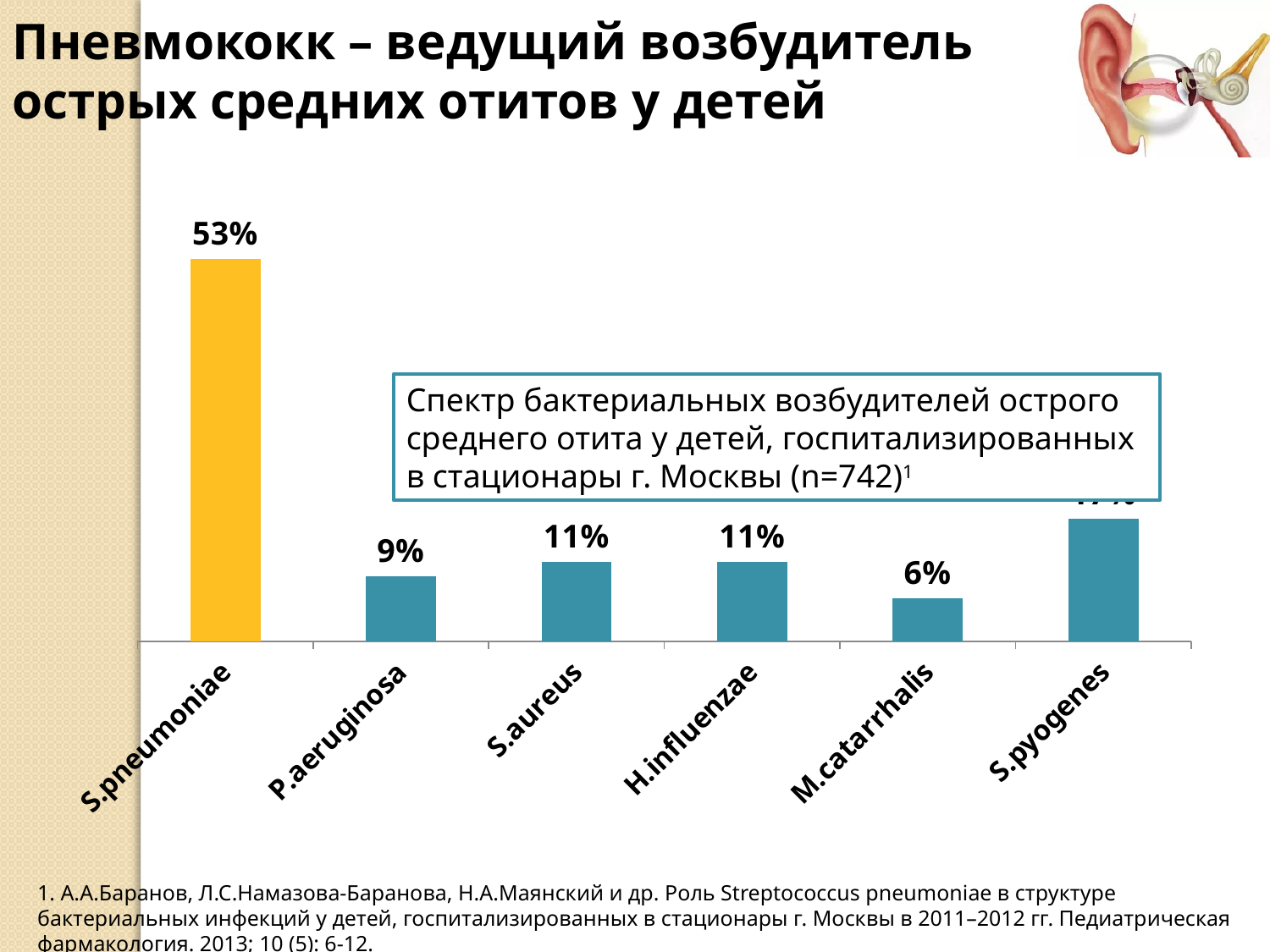
What kind of chart is shown on the slide? Bar chart What is the value for P.aeruginosa? 9% What is the value for M.catarrhalis? 6% What is the value for S.pneumoniae? 53% Which is larger, the value for S.pyogenes or the value for S.aureus? S.pyogenes Which category's bar is coloured differently (yellow) from the others? S.pneumoniae What is the value for S.aureus? 11% How many categories are shown on the chart? 6 Which category has the highest value? S.pneumoniae What is the difference between the values for S.pneumoniae and P.aeruginosa? 44% Which category has the lowest value? M.catarrhalis What is the difference between the values for S.aureus and M.catarrhalis? 5%